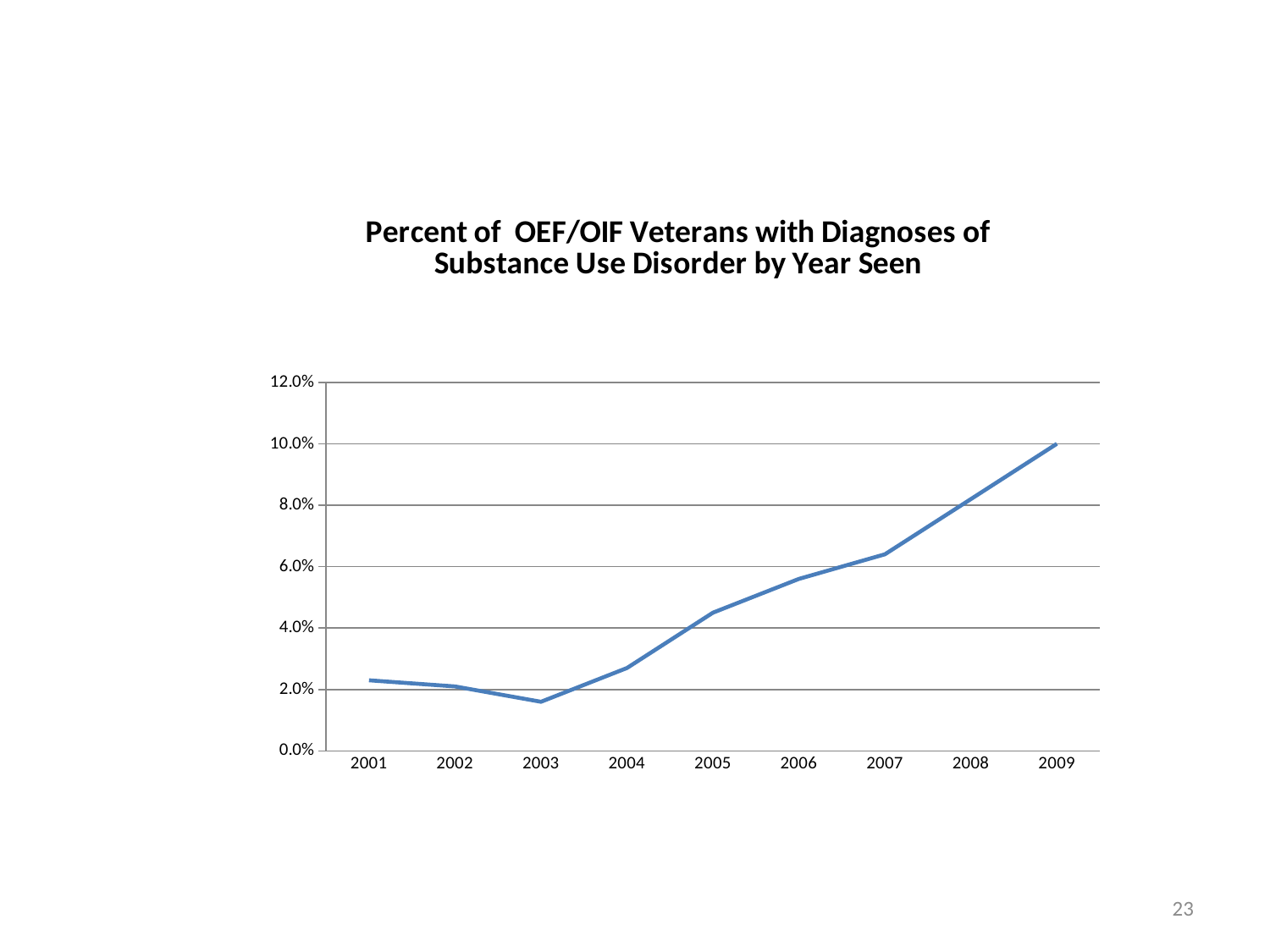
Is the value for 2003 greater or less than 2.0%? less Is the value for 2005 greater or less than 4.0%? greater Which year has the highest percent of OEF/OIF veterans with substance use disorder diagnoses? 2009 Overall, do the values rise or fall from 2003 to 2009? rise Is the value for 2007 greater or less than 6.0%? greater What kind of chart is shown on the slide? line chart What is the value for 2009? 10.0% Which year has the lowest percent of OEF/OIF veterans with substance use disorder diagnoses? 2003 How many years are plotted on the x axis of the chart? 9 Which year has a larger value, 2006 or 2004? 2006 What is the title of the chart? Percent of OEF/OIF Veterans with Diagnoses of Substance Use Disorder by Year Seen